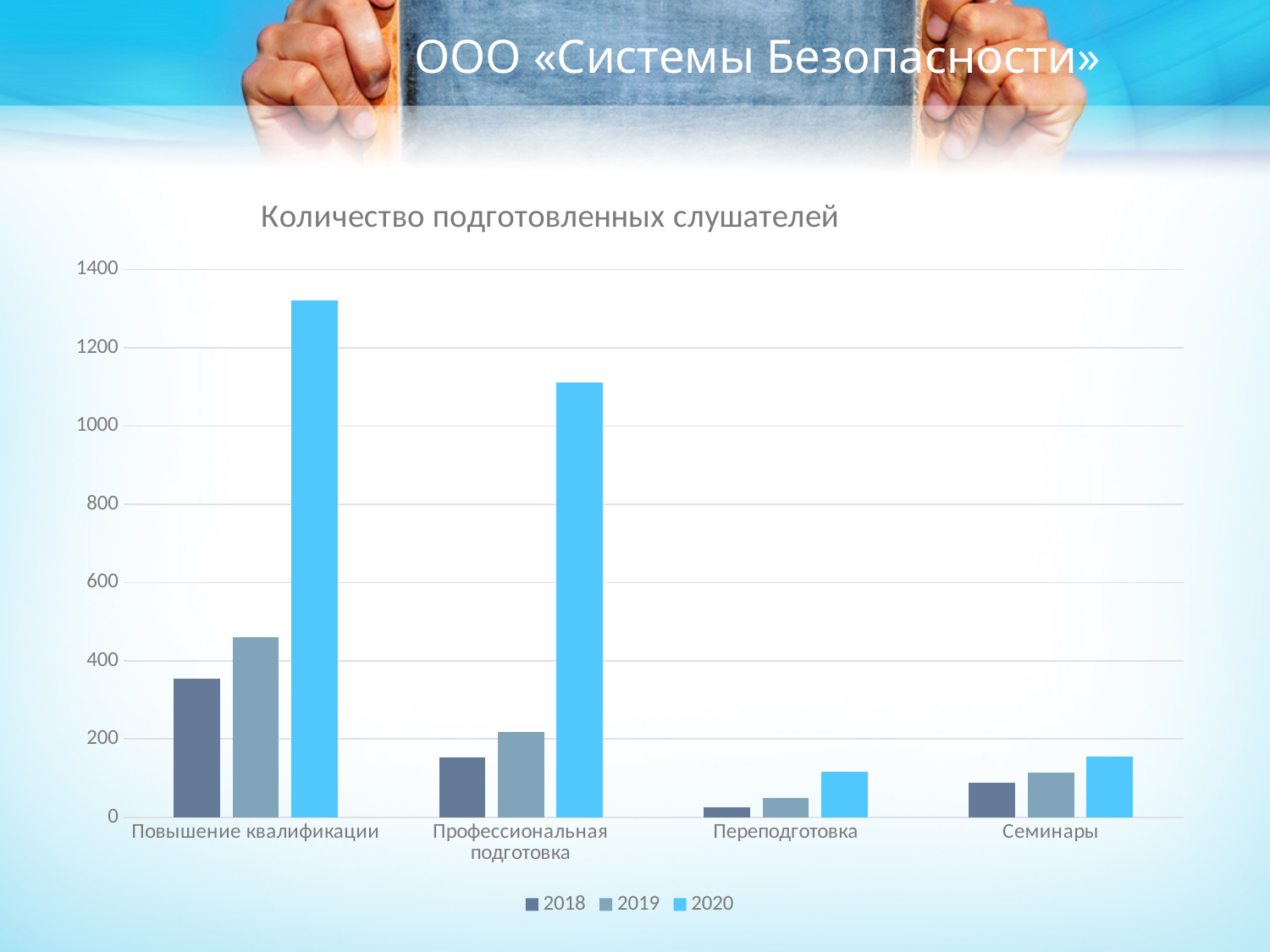
Is the 2019 value for Повышение квалификации greater or less than 400? greater How many categories are shown on the x axis? 4 Is the 2020 value for Профессиональная подготовка greater or less than 1000? greater Is the 2020 value for Повышение квалификации greater or less than 1200? greater What is the title of the chart? Количество подготовленных слушателей For Повышение квалификации, do the values rise or fall from 2018 to 2020? rise How many series does the legend list? 3 Which category has the lowest value for 2018? Переподготовка Which is larger: the 2019 value for Семинары or the 2019 value for Переподготовка? Семинары What kind of chart is shown on the slide? bar chart Which category has the highest value for 2020? Повышение квалификации